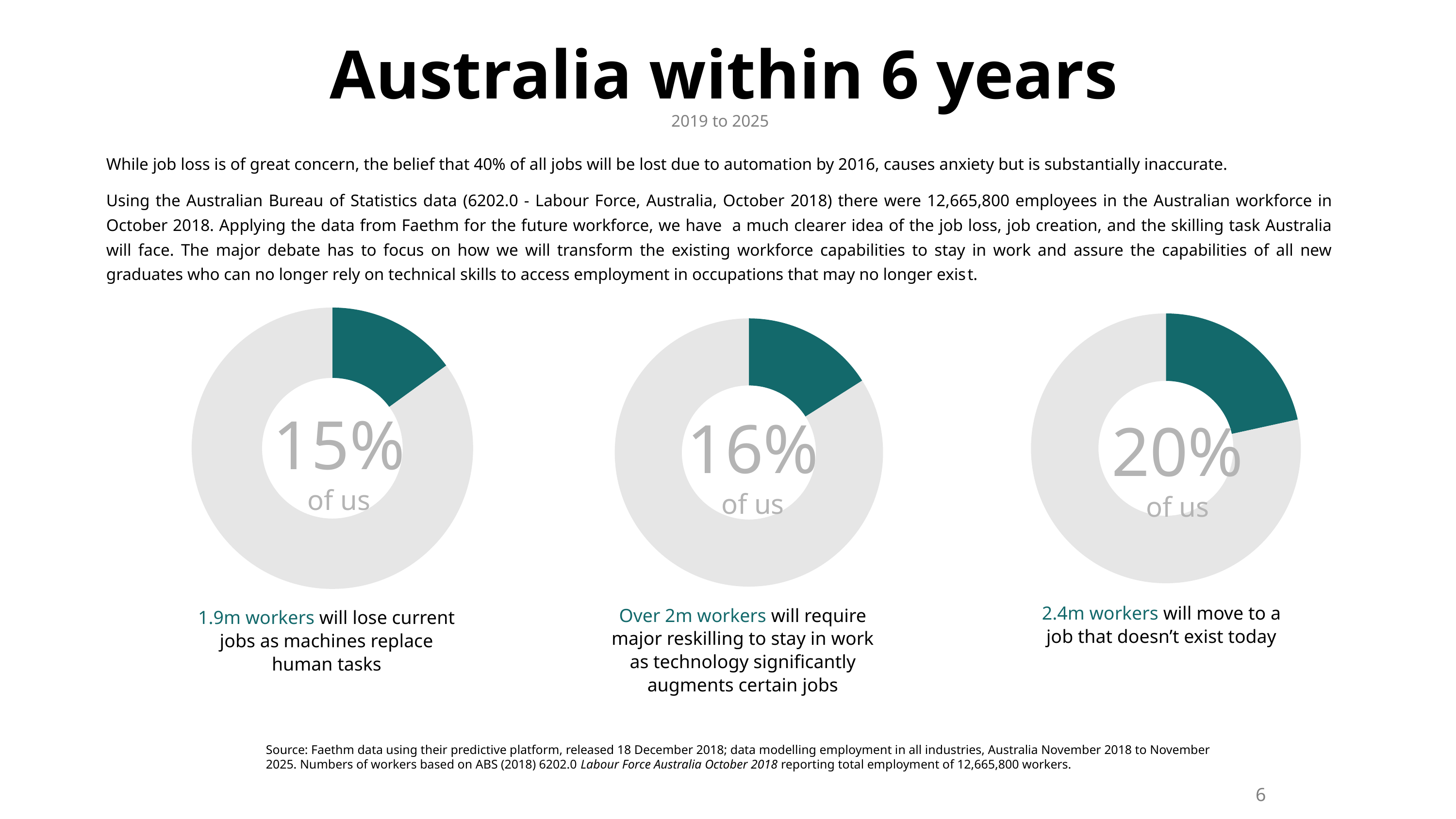
Which donut chart shows the highest percentage: the left, middle or right one? Right (20%) Which is larger: the percentage in the middle donut chart or the percentage in the right donut chart? Right donut chart (20%) Which donut chart shows the lowest percentage: the left, middle or right one? Left (15%) What percentage is shown in the centre of the left donut chart? 15% What colour is used for the highlighted slice in each donut chart? Teal (dark green) What percentage is shown in the centre of the right donut chart? 20% What is the difference in percentage points between the right donut chart (20%) and the left donut chart (15%)? 5 percentage points How many donut charts are shown on the slide? 3 What percentage is shown in the centre of the middle donut chart? 16% What kind of chart is used to show the three percentages on the slide? Donut (pie) chart According to the caption under the right donut chart, how many workers will move to a job that doesn't exist today? 2.4m workers In the left donut chart, what share of the whole does the teal slice represent? 15%